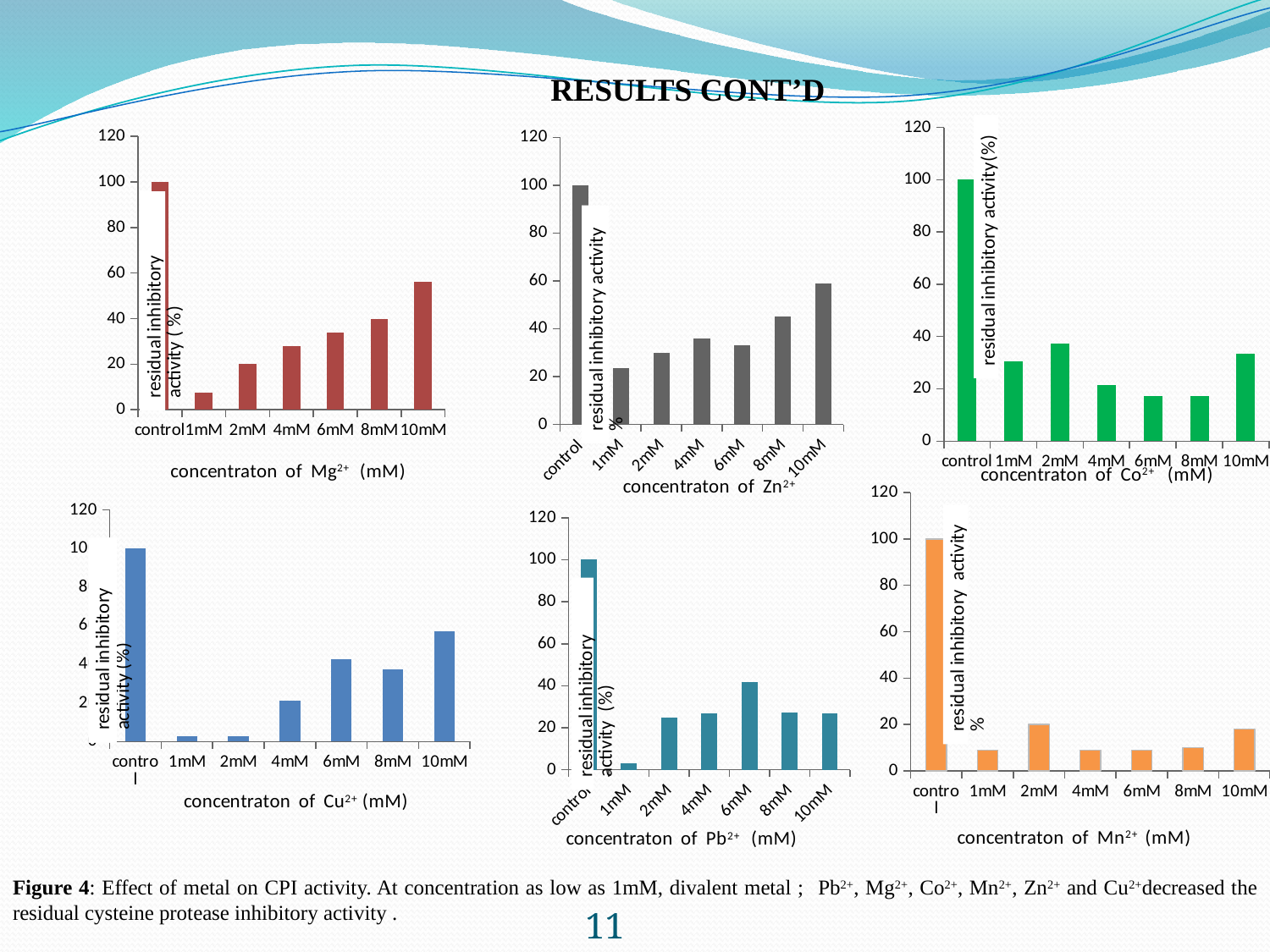
How many concentration categories are shown on the Mn²⁺ chart? 7 What kind of chart is the Pb²⁺ chart? bar chart On the Mg²⁺ chart, which concentration has the lowest residual inhibitory activity? 1mM On the Mn²⁺ chart, is the value for 1mM greater or less than 20? less On the Mg²⁺ chart, what is the residual inhibitory activity for the control? 100 On the Cu²⁺ chart, which is larger, the value for 6mM or the value for 8mM? 6mM On the Pb²⁺ chart, which concentration has the lowest residual inhibitory activity? 1mM On the Mg²⁺ chart, is the value for 10mM greater or less than 40? greater On the Zn²⁺ chart, is the value for 10mM greater or less than 40? greater On the Co²⁺ chart, which is larger, the value for 2mM or the value for 4mM? 2mM On the Zn²⁺ chart, which concentration has the highest residual inhibitory activity? control